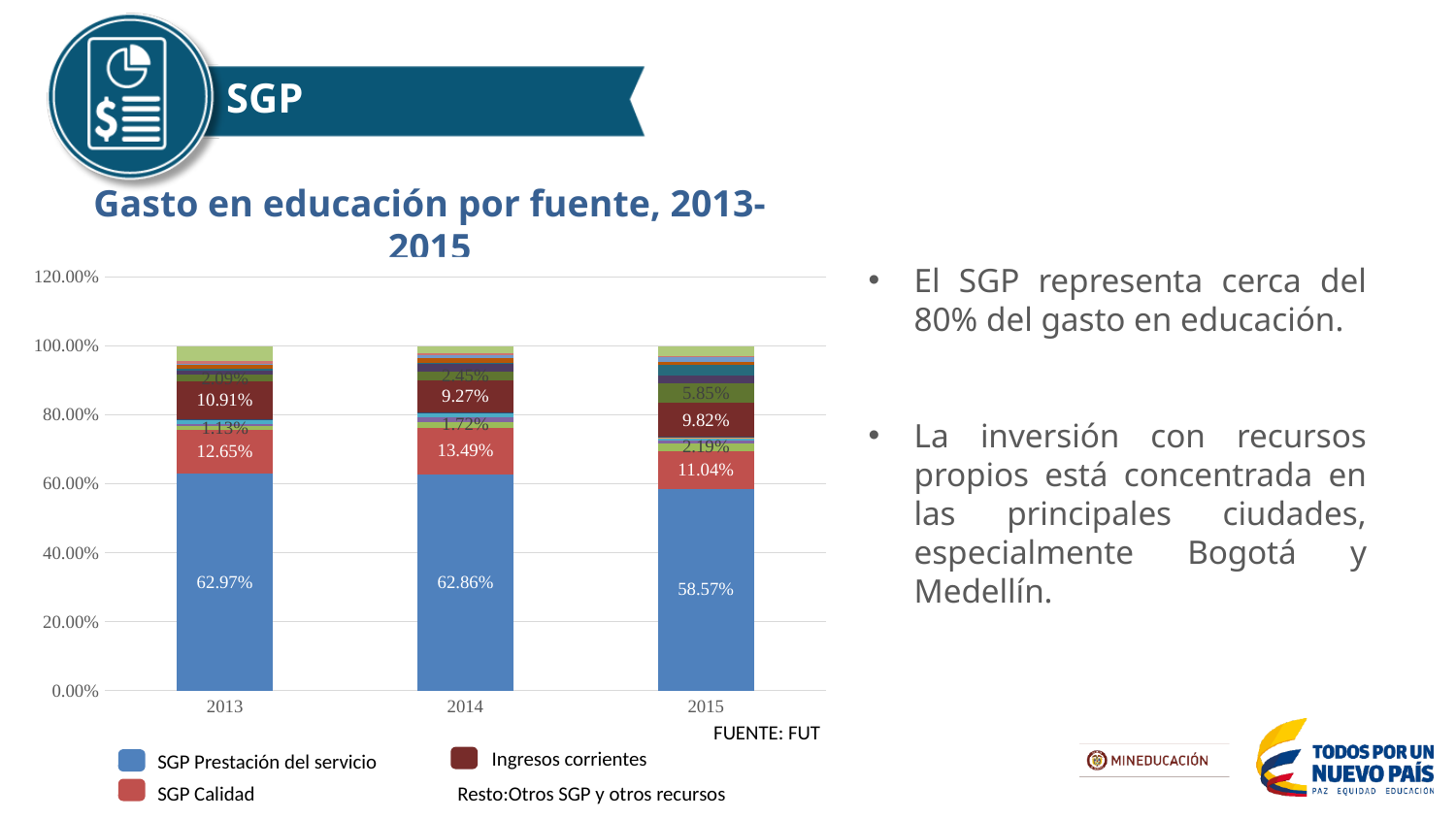
What is the difference between the SGP Prestación del servicio share in 2013 and in 2015? 4.40 percentage points How many years are shown on the x axis of the chart? 3 What is the value of Ingresos corrientes for 2013? 10.91% What is the value of Ingresos corrientes for 2015? 9.82% In which year is the SGP Calidad share the highest? 2014 In which year is the SGP Prestación del servicio share the lowest? 2015 Does the SGP Prestación del servicio share rise or fall from 2013 to 2015? It falls What is the value of SGP Prestación del servicio for 2015? 58.57% Which is larger, the Ingresos corrientes share in 2013 or in 2014? 2013 What kind of chart is shown on the slide? Stacked bar chart What is the value of SGP Calidad for 2014? 13.49% What is the value of SGP Prestación del servicio for 2013? 62.97%